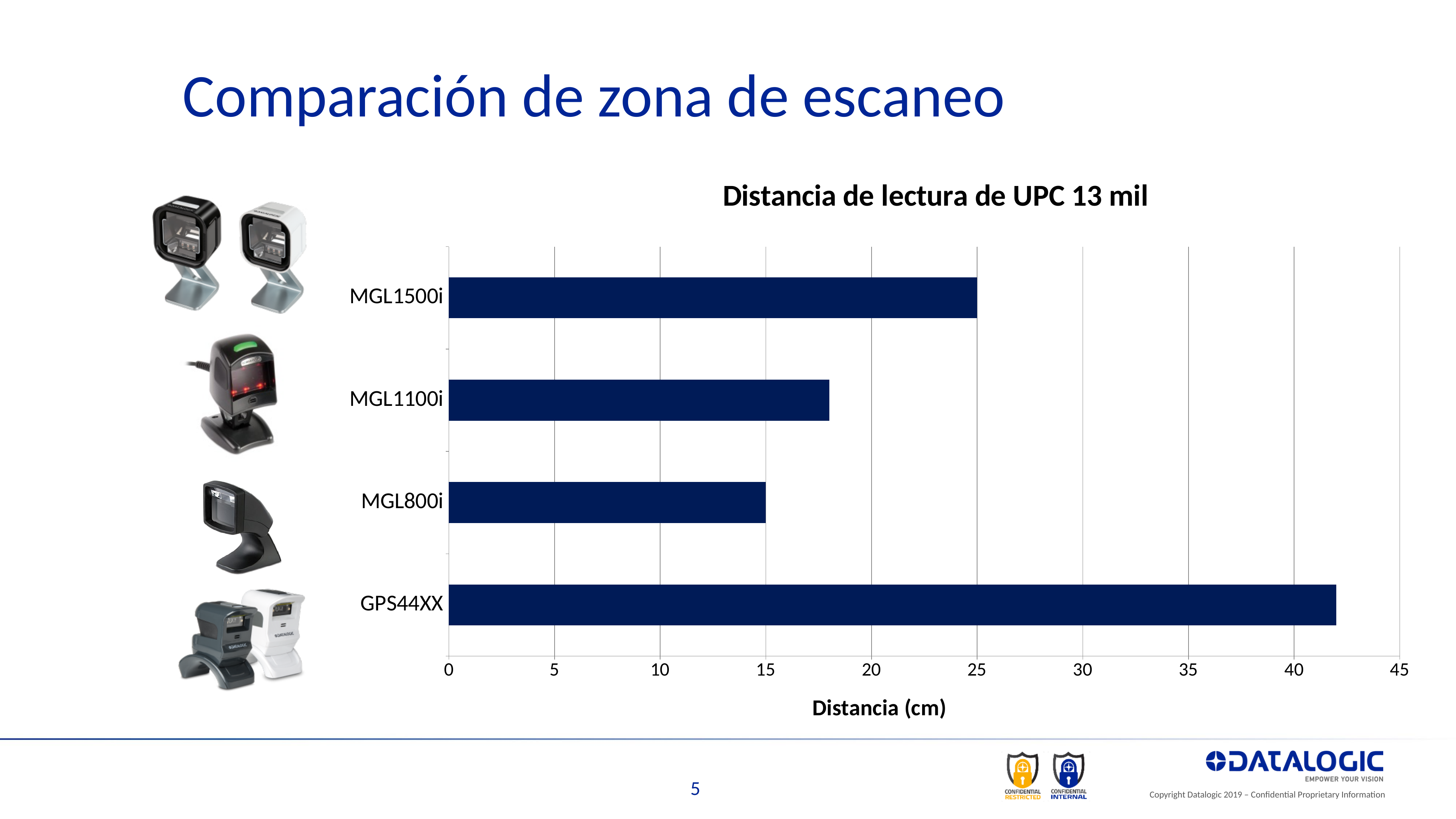
What is the title of the chart? Distancia de lectura de UPC 13 mil Which has a longer reading distance, MGL1100i or MGL1500i? MGL1500i How many categories (scanner models) are plotted in the chart? 4 What is the difference in reading distance between MGL1500i and MGL800i? 10 Is the value for MGL1100i greater or less than 20? less Which scanner model has the shortest reading distance? MGL800i What type of chart is shown on the slide? bar chart What is the reading distance for MGL800i? 15 Which scanner model has the longest reading distance? GPS44XX What is the label of the horizontal axis? Distancia (cm) Is the value for GPS44XX greater or less than 40? greater What is the reading distance for MGL1500i? 25